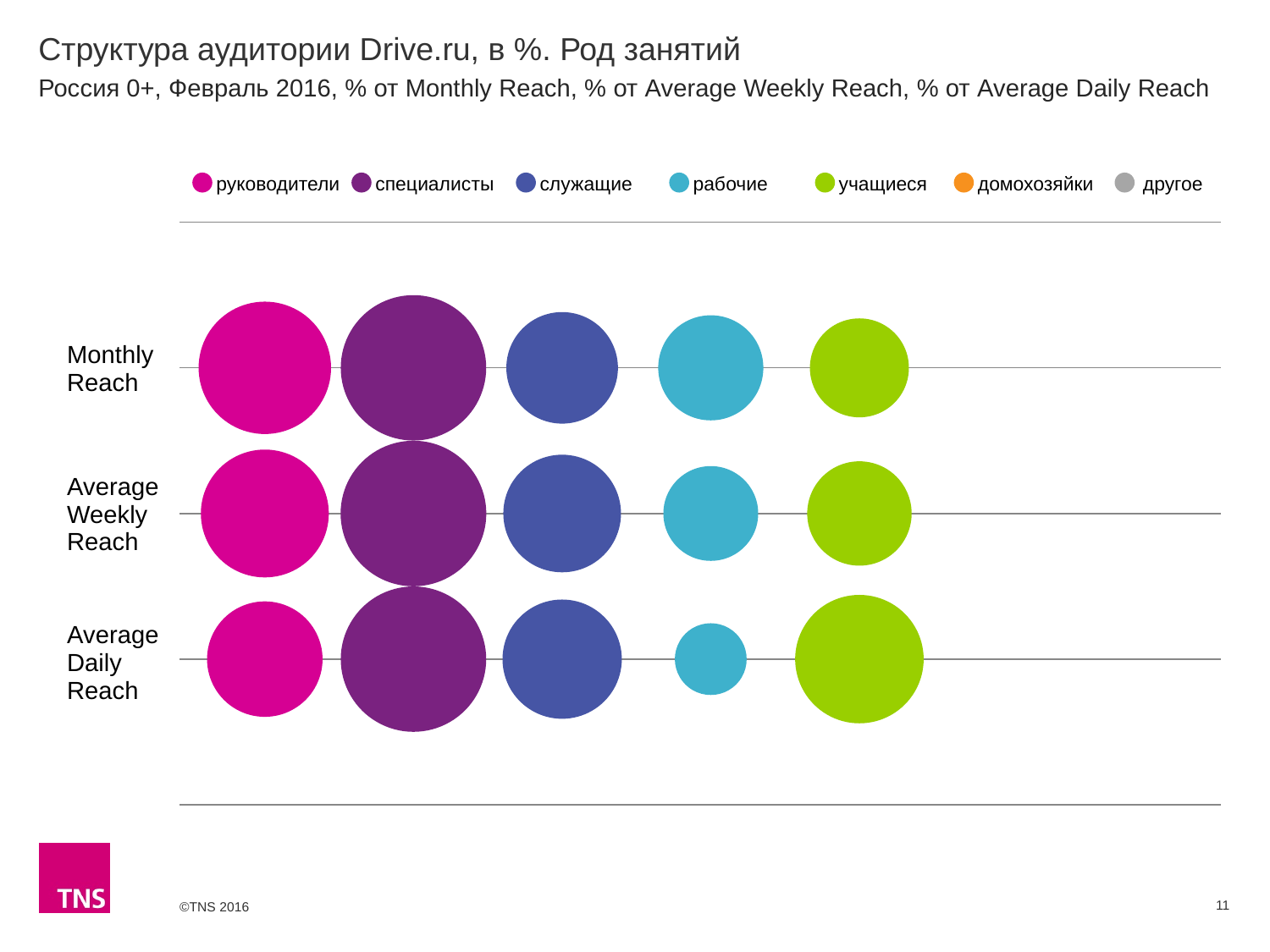
Which occupation group has the largest bubble in the Average Daily Reach row? специалисты In the Monthly Reach row, which bubble is larger: специалисты or рабочие? специалисты Does the bubble size for рабочие increase or decrease going from Monthly Reach to Average Daily Reach? decrease Which legend entry is shown in orange? домохозяйки Which occupation group has the largest bubble in the Monthly Reach row? специалисты How many reach categories (rows) are plotted on the chart? 3 Which occupation group has the smallest visible bubble in the Average Daily Reach row? рабочие What kind of chart is shown on the slide? bubble chart How many bubbles are visible in the Monthly Reach row? 5 For рабочие, which bubble is larger: Monthly Reach or Average Daily Reach? Monthly Reach For учащиеся, which bubble is larger: Monthly Reach or Average Daily Reach? Average Daily Reach How many series does the legend list? 7